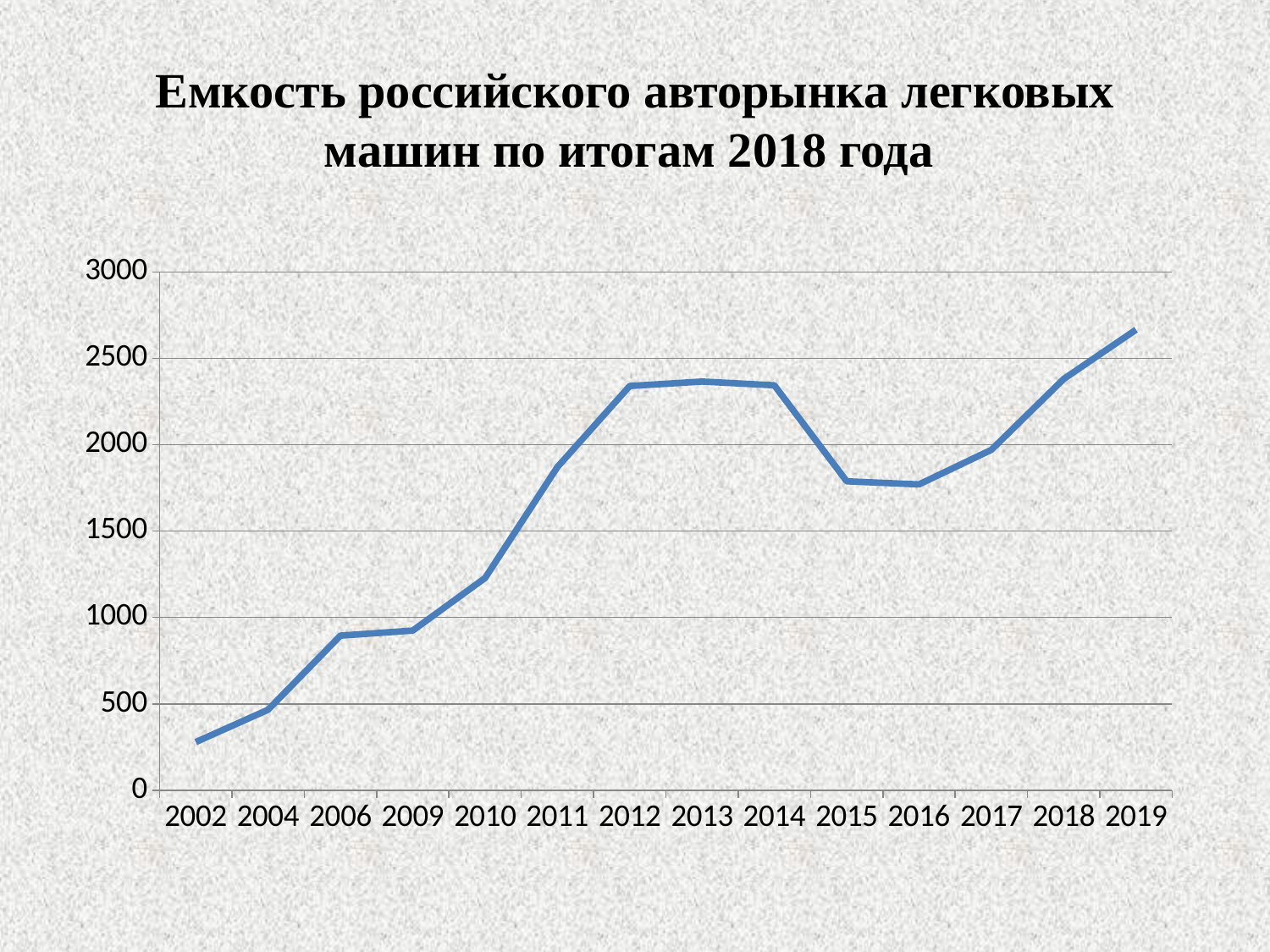
What is the title of the chart? Емкость российского авторынка легковых машин по итогам 2018 года Which year has the larger value, 2010 or 2017? 2017 Is the value for 2002 greater or less than 500? less What kind of chart is shown on the slide? line chart Is the value for 2019 greater or less than 2500? greater Is the value for 2006 greater or less than 1000? less Which year has the highest value on the chart? 2019 Do the values rise or fall from 2002 to 2012? rise How many years are plotted along the x axis? 14 Which year has the lowest value on the chart? 2002